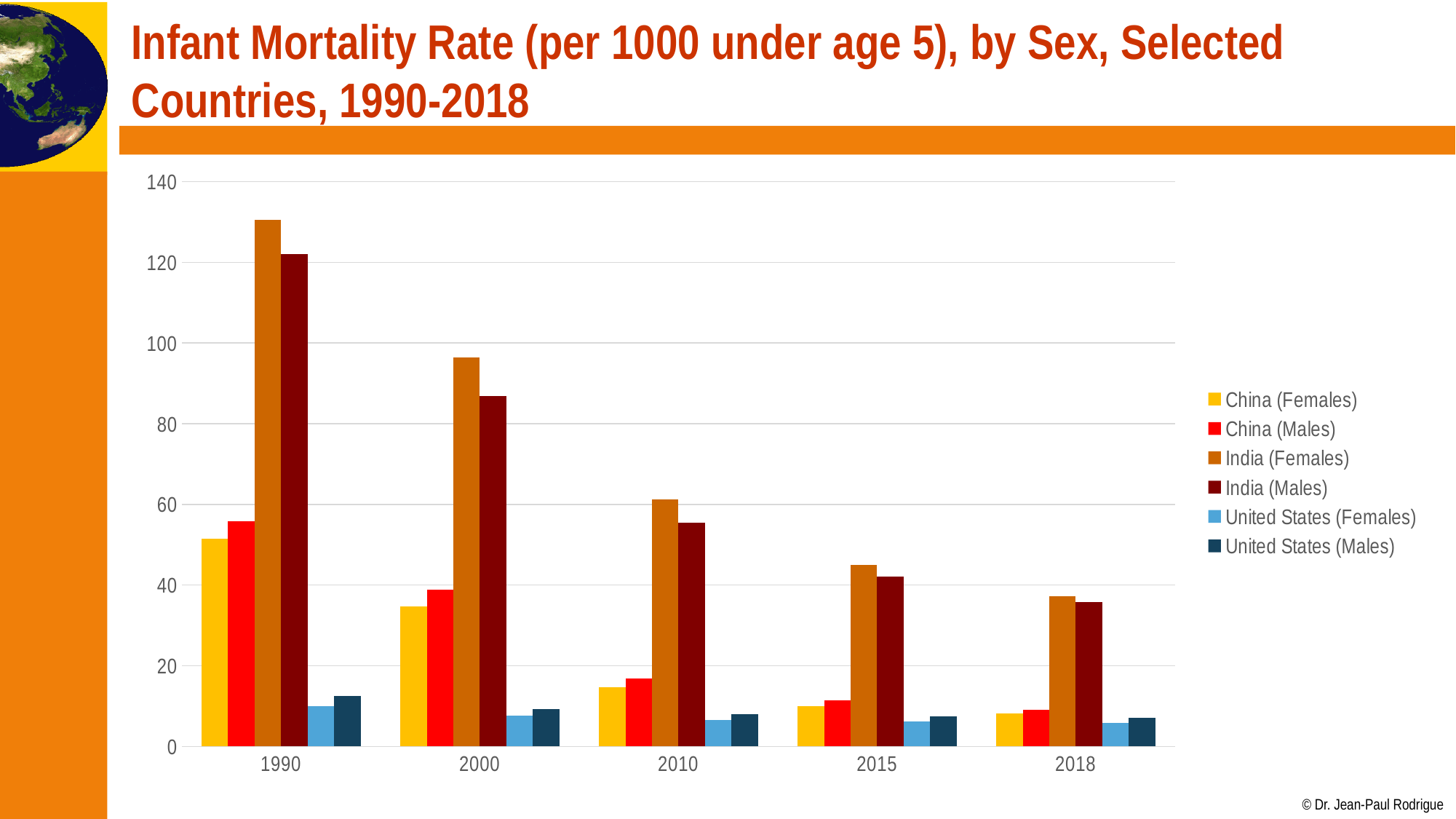
Which series has the lowest value in 1990? United States (Females) Which series has the highest value in 1990? India (Females) Do the values for India (Females) rise or fall from 1990 to 2018? Fall In 2000, which is larger: India (Females) or India (Males)? India (Females) How many years are shown along the x axis? 5 Is the value for India (Males) in 2000 greater or less than 80? greater Is the value for China (Females) in 2010 greater or less than 20? less Is the value for India (Females) in 2015 greater or less than 40? greater What kind of chart is shown on the slide? Bar chart What colour represents India (Males) in the legend? Dark red How many series does the legend list? 6